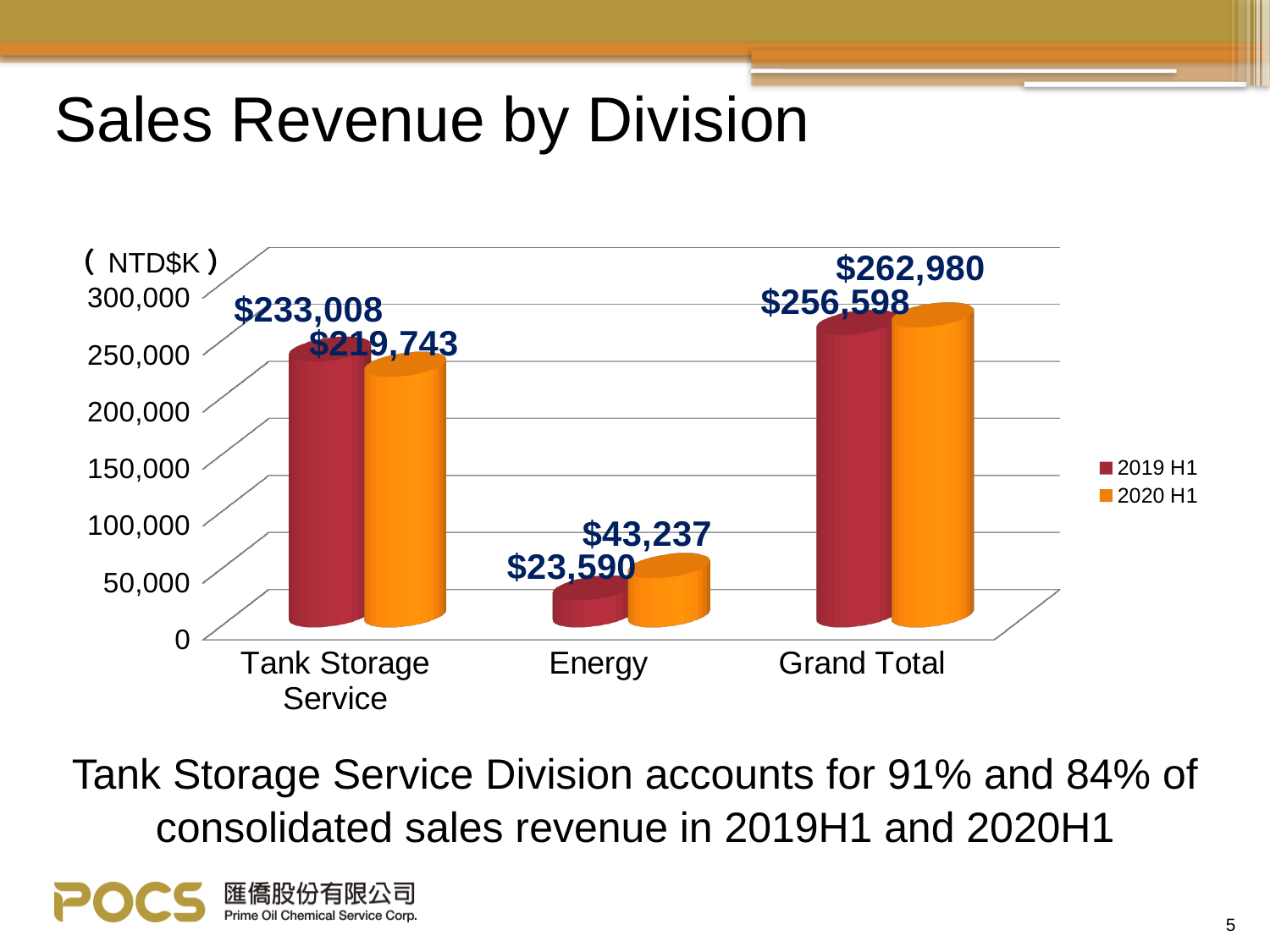
What is the 2019 H1 value for Energy? $23,590 What is the 2020 H1 value for Grand Total? $262,980 Is the 2020 H1 value for Tank Storage Service larger or smaller than the 2019 H1 value? smaller How many series does the legend list? 2 What is the 2020 H1 sales revenue for Energy? $43,237 Which division has the lowest 2020 H1 sales revenue? Energy What is the difference between the 2019 H1 and 2020 H1 values for Tank Storage Service? $13,265 By how much did Energy revenue increase from 2019 H1 to 2020 H1? $19,647 What is the 2019 H1 sales revenue for Tank Storage Service? $233,008 What type of chart is shown on the slide? bar chart Which category has the highest 2019 H1 value? Grand Total How many categories are shown on the x axis? 3